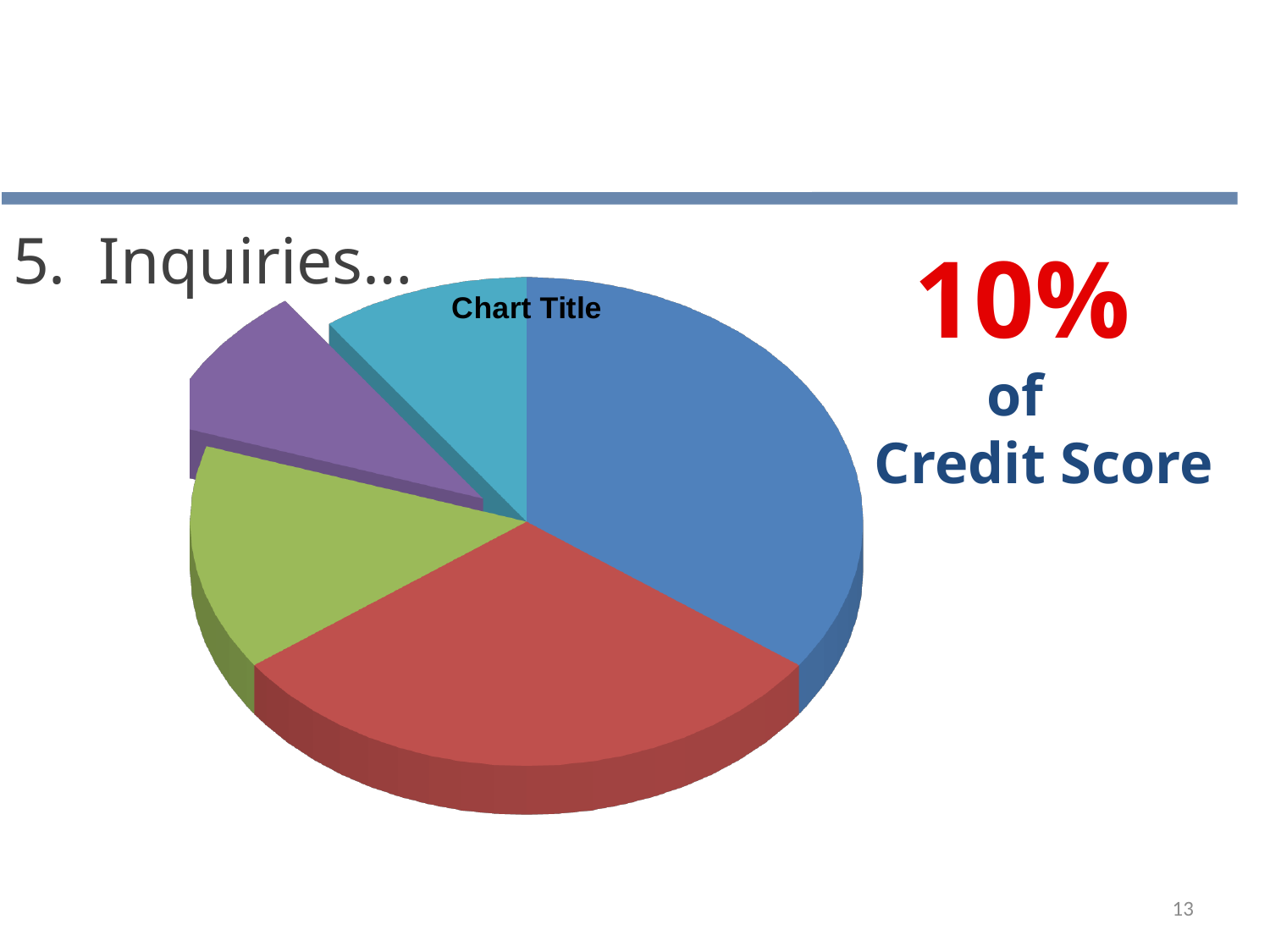
Which slice is larger, the blue slice or the purple slice? blue Which slice is larger, the red slice or the teal slice? red Which slice is larger, the red slice or the green slice? red Which colour slice is the largest in the pie chart? blue Which colour slice is pulled out (exploded) from the pie chart? purple What is the title shown on the pie chart? Chart Title What kind of chart is shown on the slide? pie chart How many slices does the pie chart have? 5